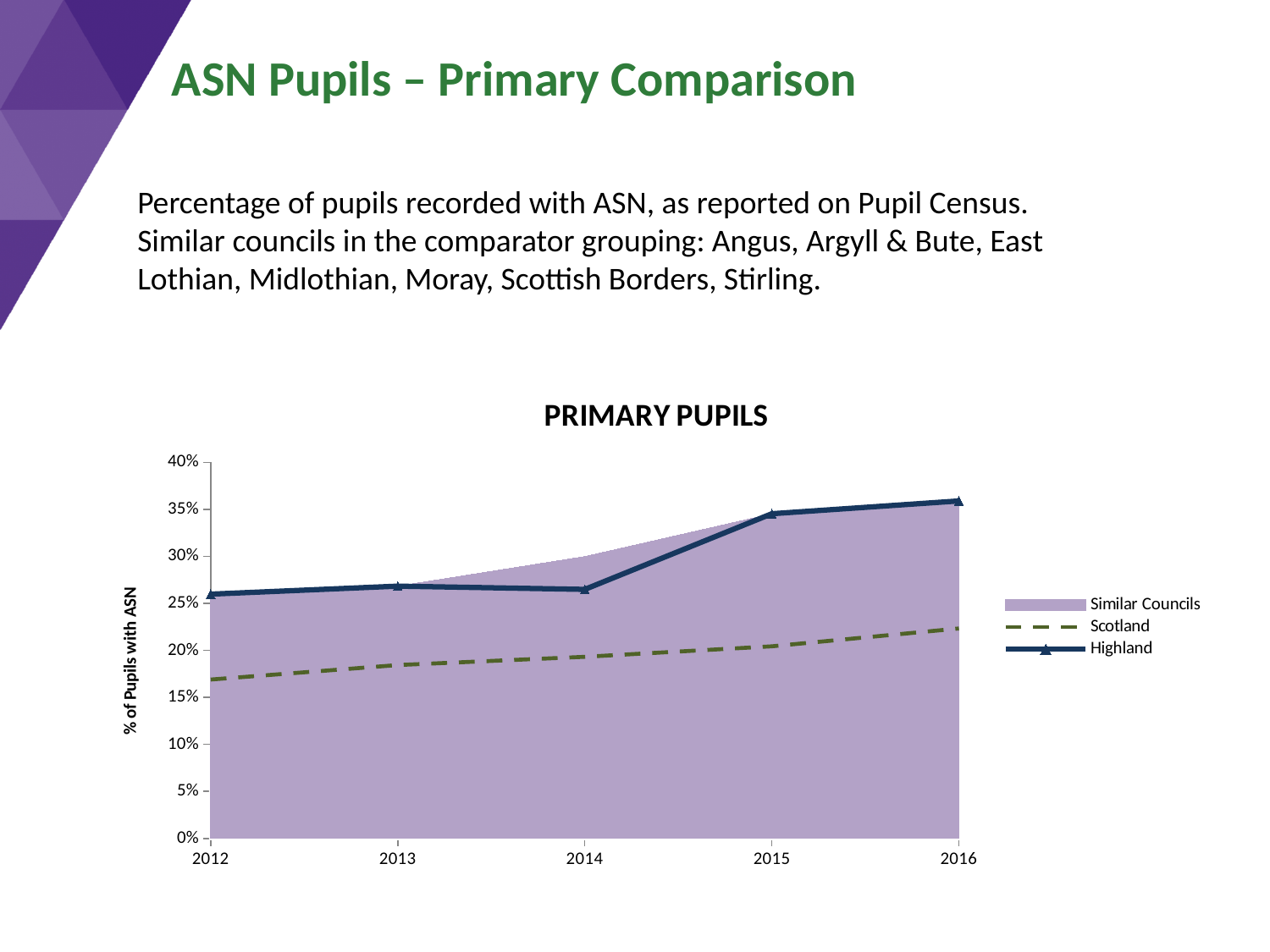
Is the Highland value for 2015 greater or less than 30%? greater What is the title of the chart on the slide? PRIMARY PUPILS Does the Scotland series rise or fall from 2012 to 2016? rise Is the Highland value for 2014 greater or less than 30%? less Is the Scotland value for 2016 greater or less than 20%? greater How many series does the chart legend list? 3 How many years are shown along the x axis of the chart? 5 In which year is the Scotland value lowest? 2012 Which series in the chart is drawn as a dashed line? Scotland In 2014, which is larger: the Similar Councils value or the Highland value? Similar Councils In 2016, which is larger: the Highland value or the Scotland value? Highland